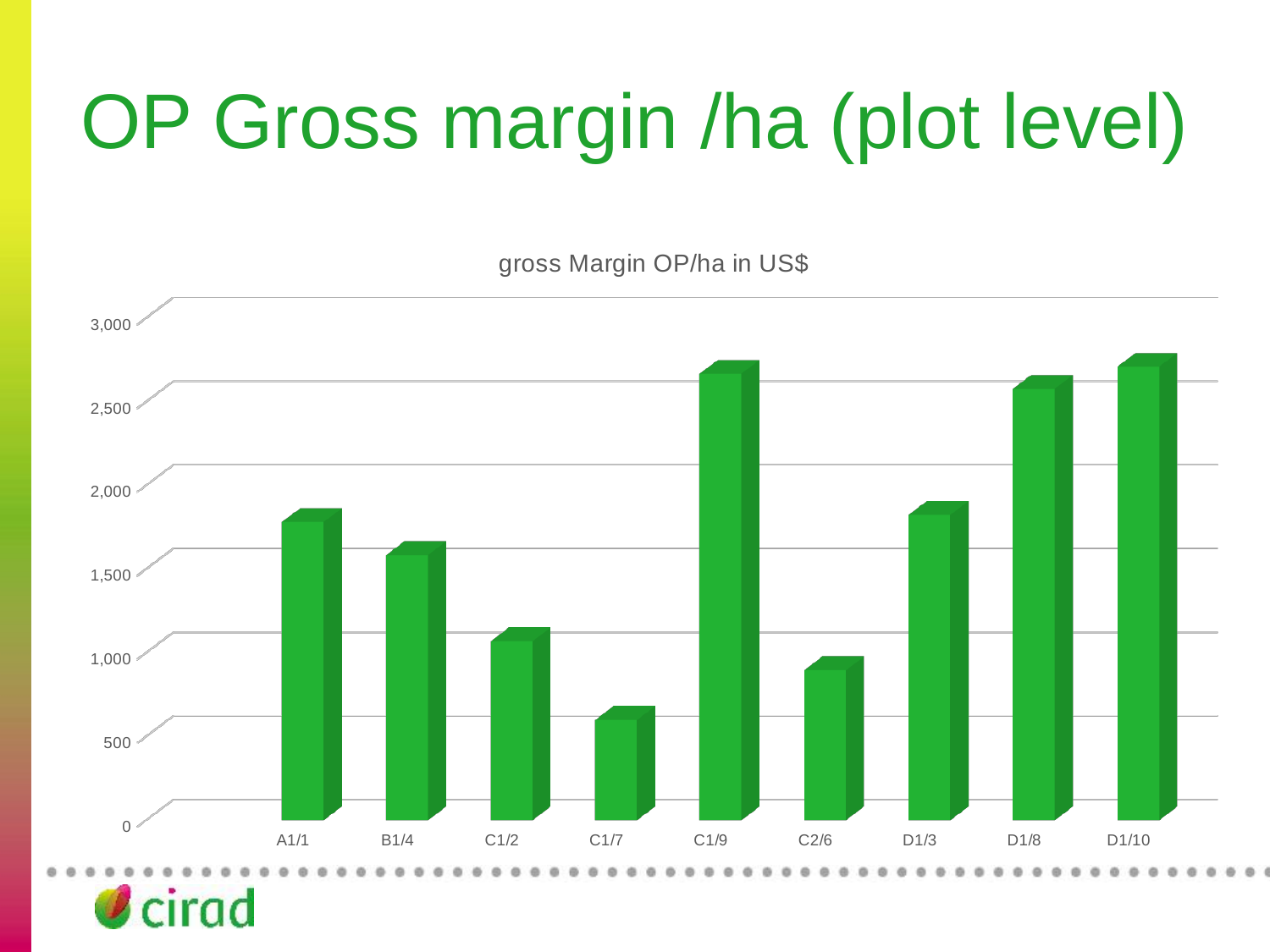
Which has the larger gross margin OP/ha, C1/9 or D1/3? C1/9 What kind of chart is shown on the slide? bar chart Which plot has the lowest gross margin OP/ha? C1/7 Which has the larger gross margin OP/ha, C1/7 or C2/6? C2/6 What is the title of the chart? gross Margin OP/ha in US$ Is the value for A1/1 greater or less than 2,000? less How many plots (categories) are shown on the x axis of the chart? 9 Which has the larger gross margin OP/ha, A1/1 or B1/4? A1/1 Is the value for C1/7 greater or less than 1,000? less Is the value for B1/4 greater or less than 1,000? greater